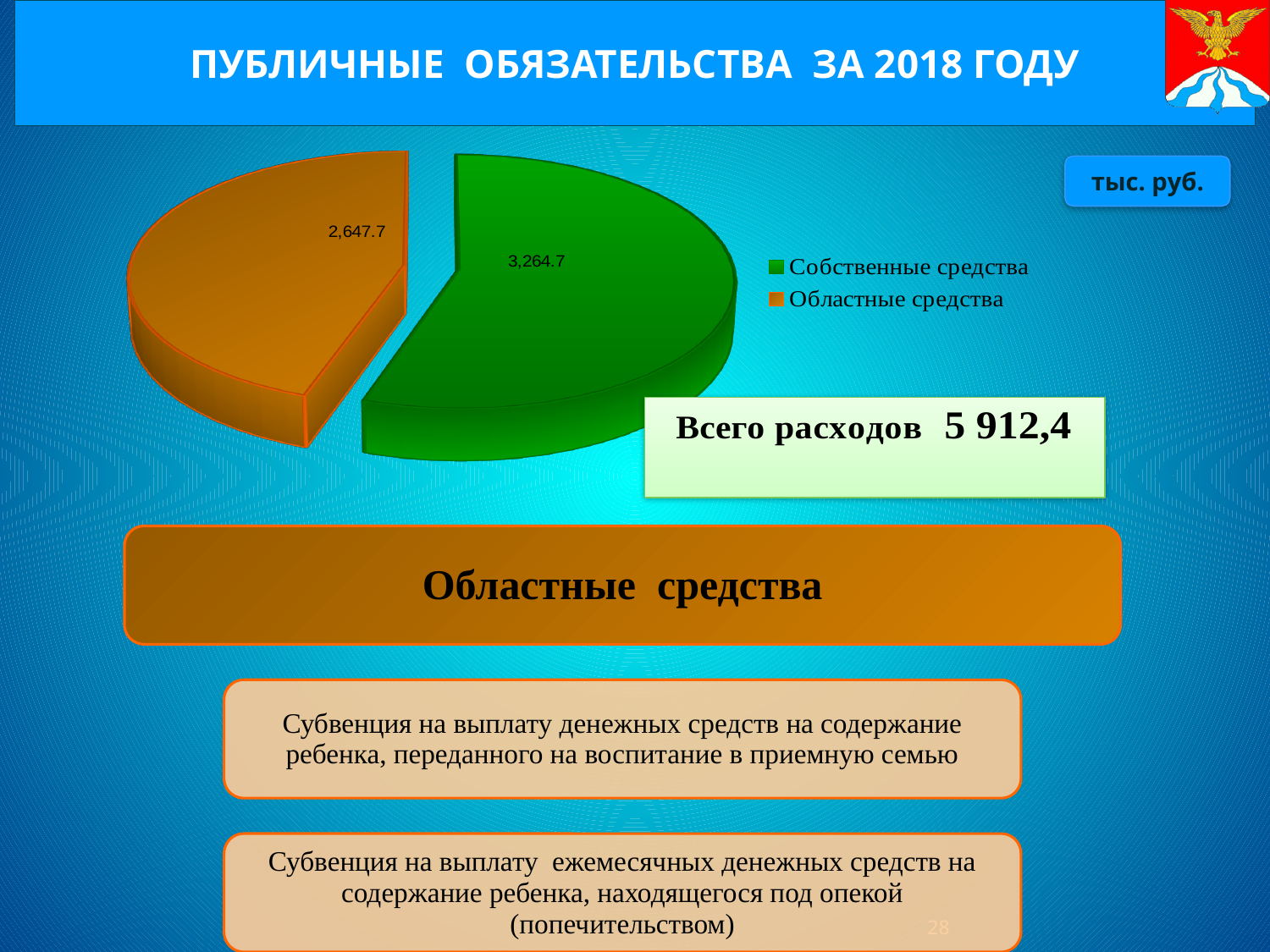
Which slice of the pie chart is the smallest? Областные средства Which slice of the pie chart is the largest? Собственные средства Which is larger: Собственные средства or Областные средства? Собственные средства What is the difference between Собственные средства and Областные средства? 617.0 How many slices does the pie chart have? 2 What is the total of the two slices in the pie chart? 5,912.4 How many entries does the legend list? 2 What unit is indicated for the chart values? тыс. руб. What colour is the Областные средства slice? Orange What is the value for Областные средства in the pie chart? 2,647.7 What type of chart is shown on the slide? Pie chart What is the value for Собственные средства in the pie chart? 3,264.7